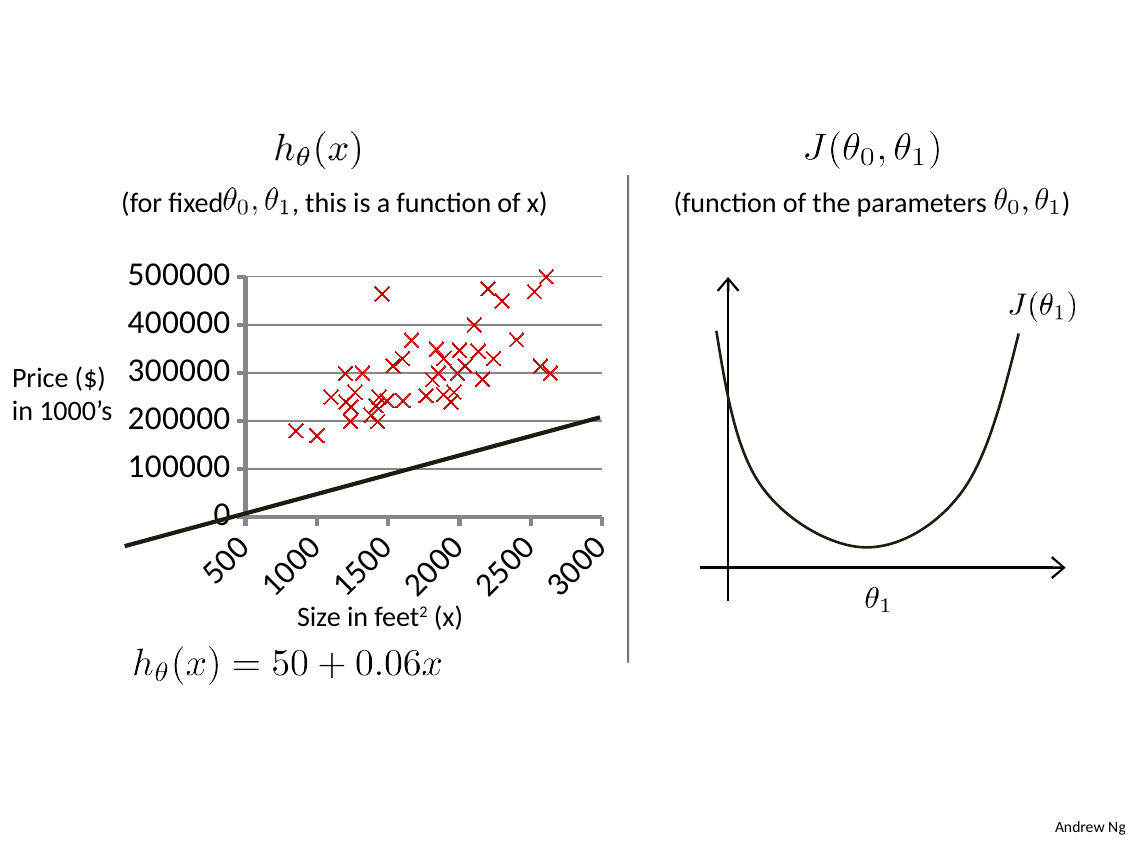
On the left chart, what is the label of the x axis? Size in feet² (x) On the left chart, do the prices generally rise or fall as size in feet² increases? rise On the left chart, is the price of the data point at about 2600 feet² near the top of the chart greater or less than 400000? greater On the left chart, what is the largest value marked on the x axis? 3000 On the left chart, what is the highest value marked on the y axis? 500000 On the left chart, is the price of the data point near 1000 feet² greater or less than 300000? less On the left chart, is the price of the highest data point greater or less than 400000? greater On the left chart, what is the smallest value marked on the x axis? 500 What kind of chart is the left chart showing price against size? scatter chart On the left chart, what colour are the data point markers? red